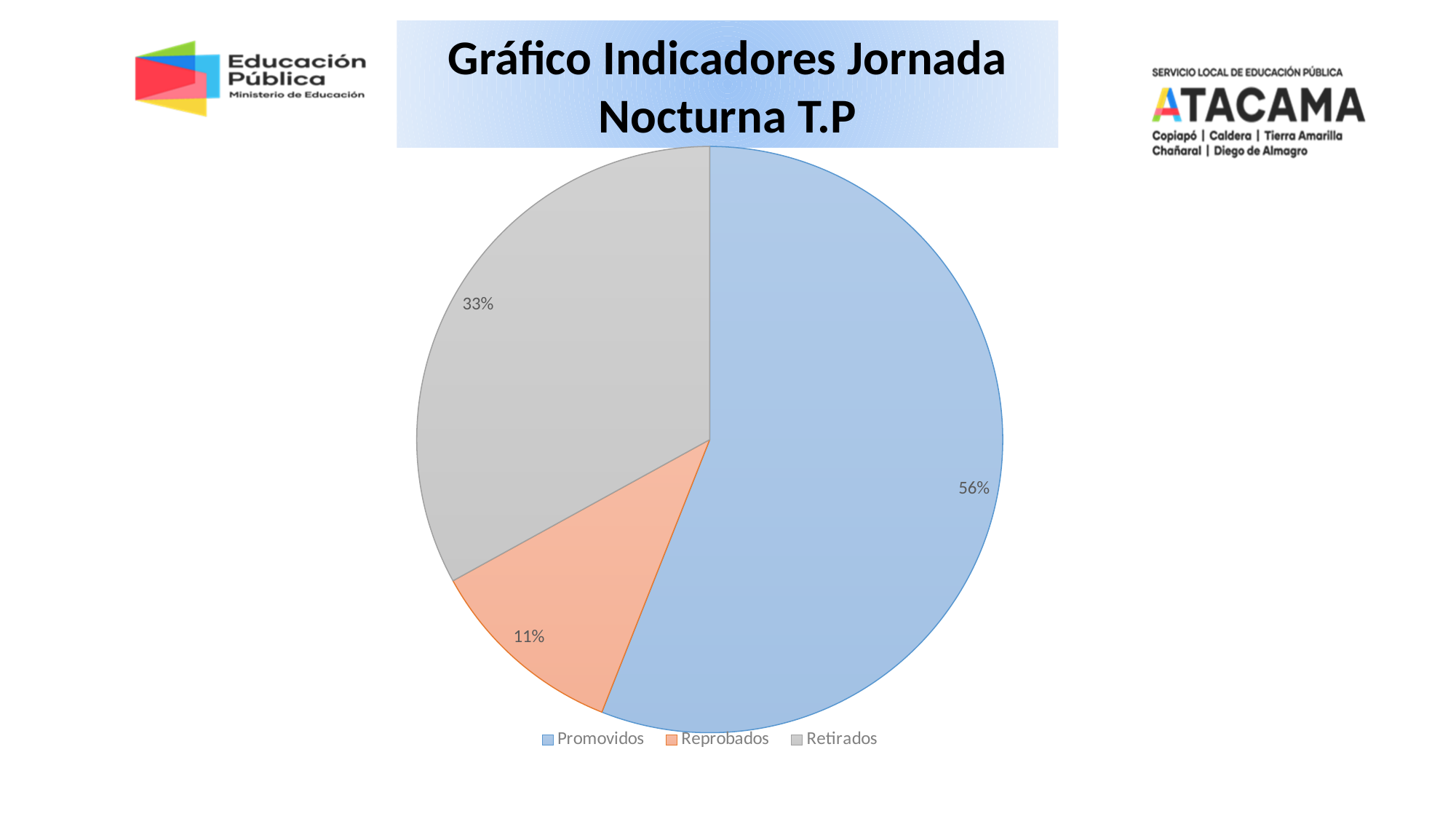
What percentage of the pie is Retirados? 33% How many categories does the pie chart show? 3 Which category has the smallest share of the pie? Reprobados What type of chart is shown on the slide? pie chart Which colour represents Reprobados in the legend? orange Which category has the largest share of the pie? Promovidos What percentage of the pie is Reprobados? 11% What is the title of the chart? Gráfico Indicadores Jornada Nocturna T.P What is the difference in percentage points between Retirados and Reprobados? 22 Which is larger, the share for Retirados or the share for Reprobados? Retirados What is the difference in percentage points between Promovidos and Retirados? 23 What percentage of the pie is Promovidos? 56%